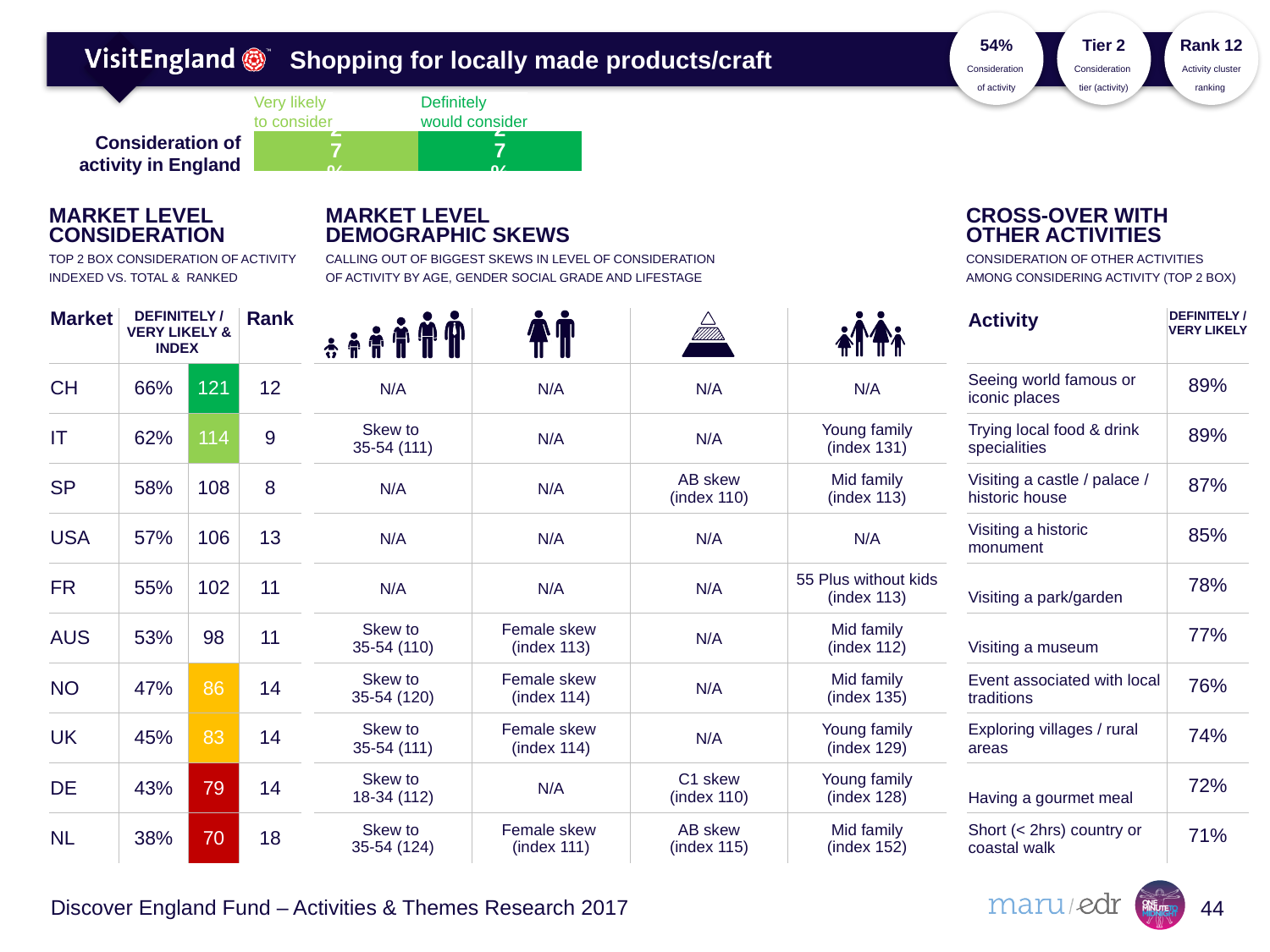
What is the total of the stacked bar in the 'Consideration of activity in England' chart? 54% How many bars are plotted in the 'Consideration of activity in England' chart? 1 In the 'Consideration of activity in England' chart, what is the value for 'Very likely to consider'? 27% In the 'Consideration of activity in England' chart, what is the value for 'Definitely would consider'? 27% What kind of chart is the 'Consideration of activity in England' chart? bar chart What are the two series shown in the 'Consideration of activity in England' chart? Very likely to consider; Definitely would consider In the 'Consideration of activity in England' chart, which series is shown in the lighter green? Very likely to consider How many series does the legend of the 'Consideration of activity in England' chart list? 2